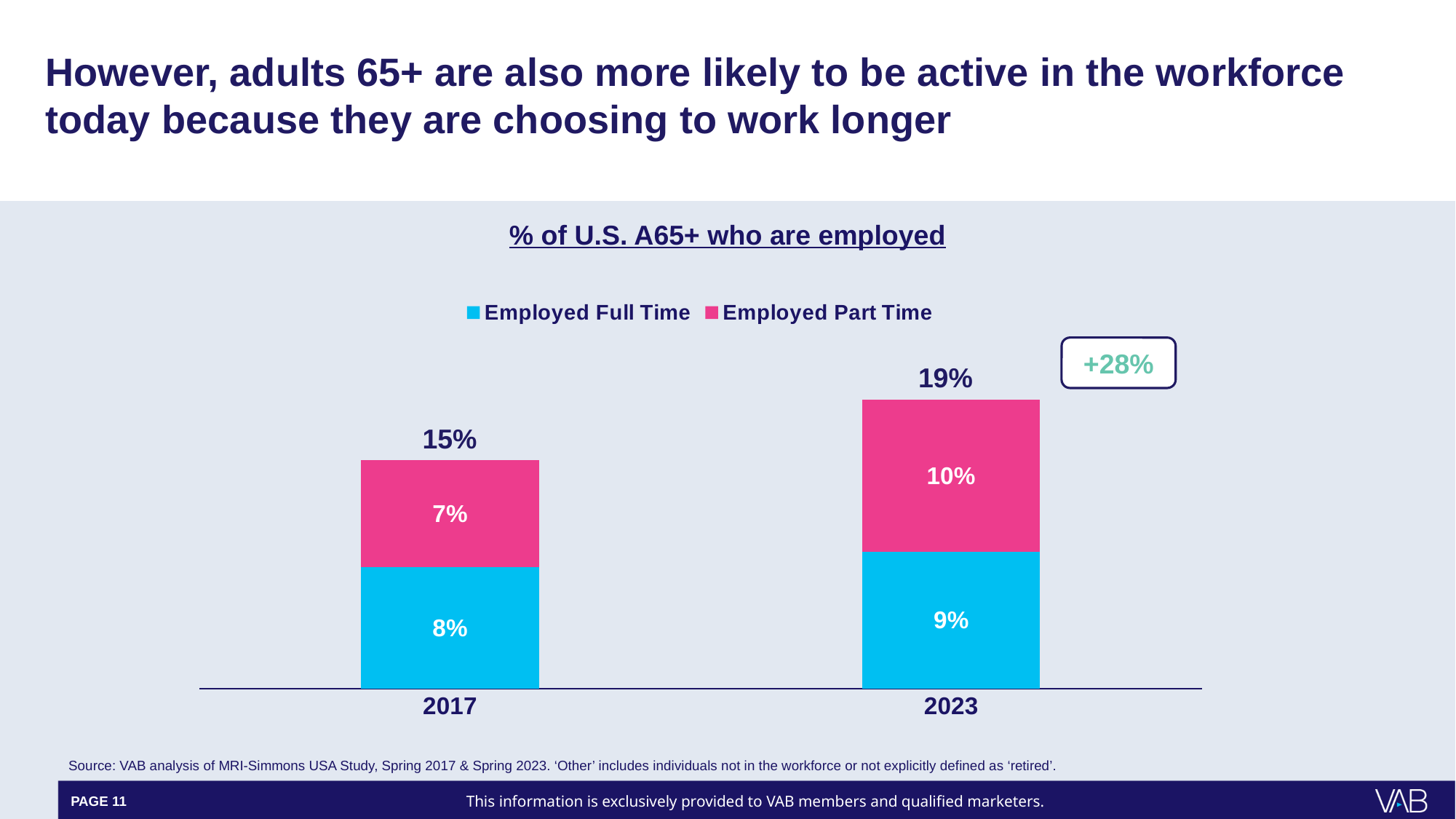
What kind of chart is shown on the slide? Stacked bar chart What is the total of the stacked bar for 2017? 15% What is the difference between the Employed Part Time values for 2023 and 2017? 3% What is the Employed Part Time value for 2023? 10% How many years are shown on the x axis? 2 Is the Employed Full Time value larger in 2017 or 2023? 2023 Which year has the higher total percentage of U.S. A65+ who are employed? 2023 What is the Employed Full Time value for 2017? 8% What is the total of the stacked bar for 2023? 19% How many series does the legend list? 2 What is the Employed Full Time value for 2023? 9% What is the Employed Part Time value for 2017? 7%